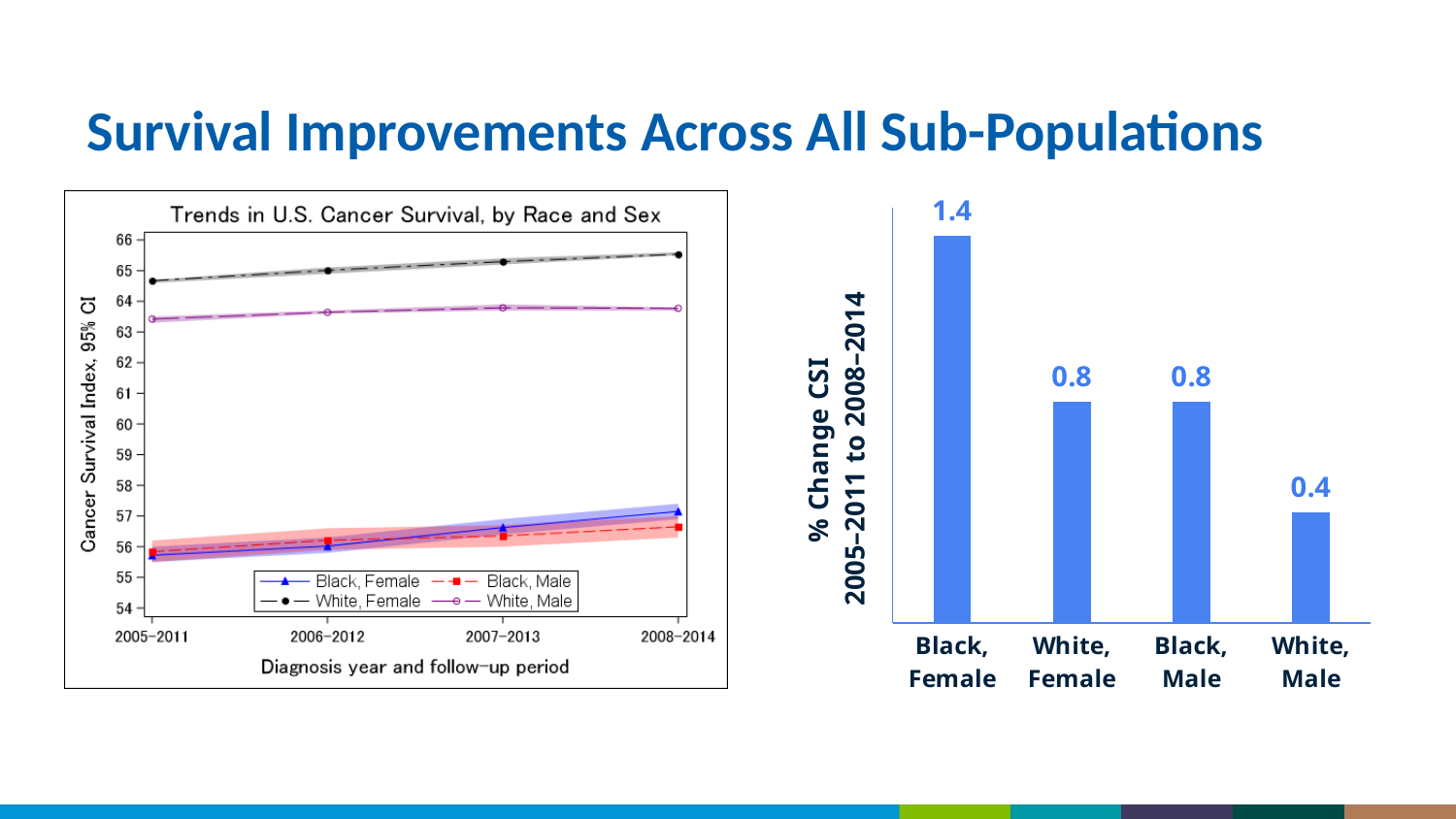
In the chart titled 'Trends in U.S. Cancer Survival, by Race and Sex', is the value for White, Female at 2005-2011 greater or less than 64? greater How many series does the legend of the chart titled 'Trends in U.S. Cancer Survival, by Race and Sex' list? 4 In the bar chart on the right, which group has the lowest % change in CSI? White, Male What kind of chart is the chart on the right? bar chart In the chart titled 'Trends in U.S. Cancer Survival, by Race and Sex', does the White, Female line rise or fall from 2005-2011 to 2008-2014? rise In the bar chart on the right, what is the difference between the % change for Black, Female and White, Male? 1.0 In the bar chart on the right, what is the % change in CSI for White, Male? 0.4 In the chart titled 'Trends in U.S. Cancer Survival, by Race and Sex', is the value for Black, Male at 2008-2014 greater or less than 58? less In the bar chart on the right, is the % change for White, Female larger or smaller than for White, Male? larger How many groups are shown in the bar chart on the right? 4 In the bar chart on the right, which group has the highest % change in CSI? Black, Female In the bar chart on the right, what is the % change in CSI for Black, Female? 1.4